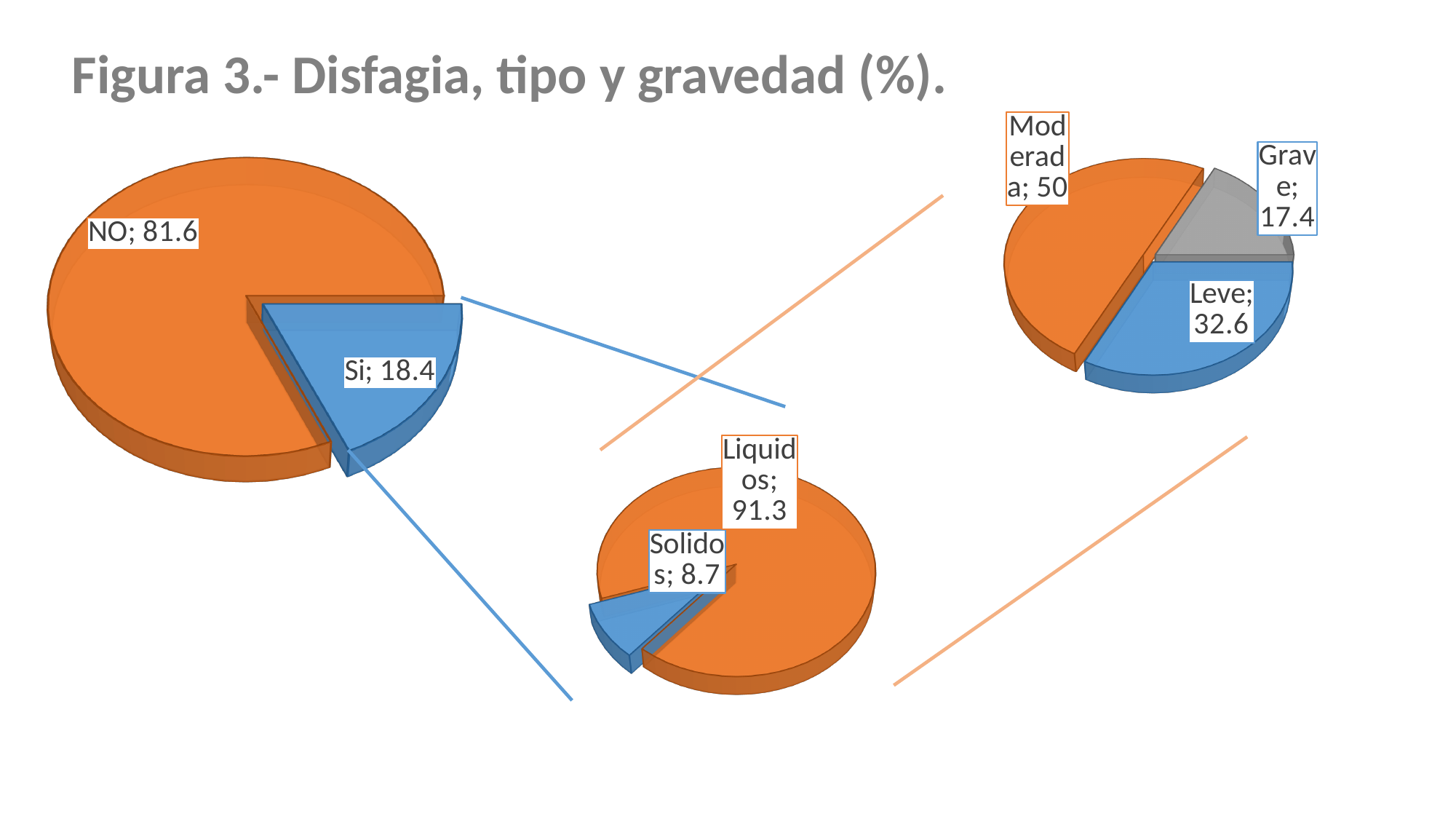
In the pie chart on the left of the slide, which is larger, NO or Si? NO In the pie chart on the left of the slide, what is the value for NO? 81.6 In the pie chart on the right of the slide, what is the value for Leve? 32.6 How many slices does the pie chart on the right of the slide have? 3 What is the title of the slide's figure? Figura 3.- Disfagia, tipo y gravedad (%). In the pie chart on the right of the slide, which category has the largest slice? Moderada In the pie chart at the bottom centre of the slide, what is the value for Liquidos? 91.3 In the pie chart on the left of the slide, what is the value for Si? 18.4 In the pie chart on the right of the slide, which category has the smallest slice? Grave In the pie chart on the right of the slide, what is the difference between the values for Moderada and Leve? 17.4 In the pie chart at the bottom centre of the slide, what is the value for Solidos? 8.7 In the pie chart on the right of the slide, what is the value for Grave? 17.4